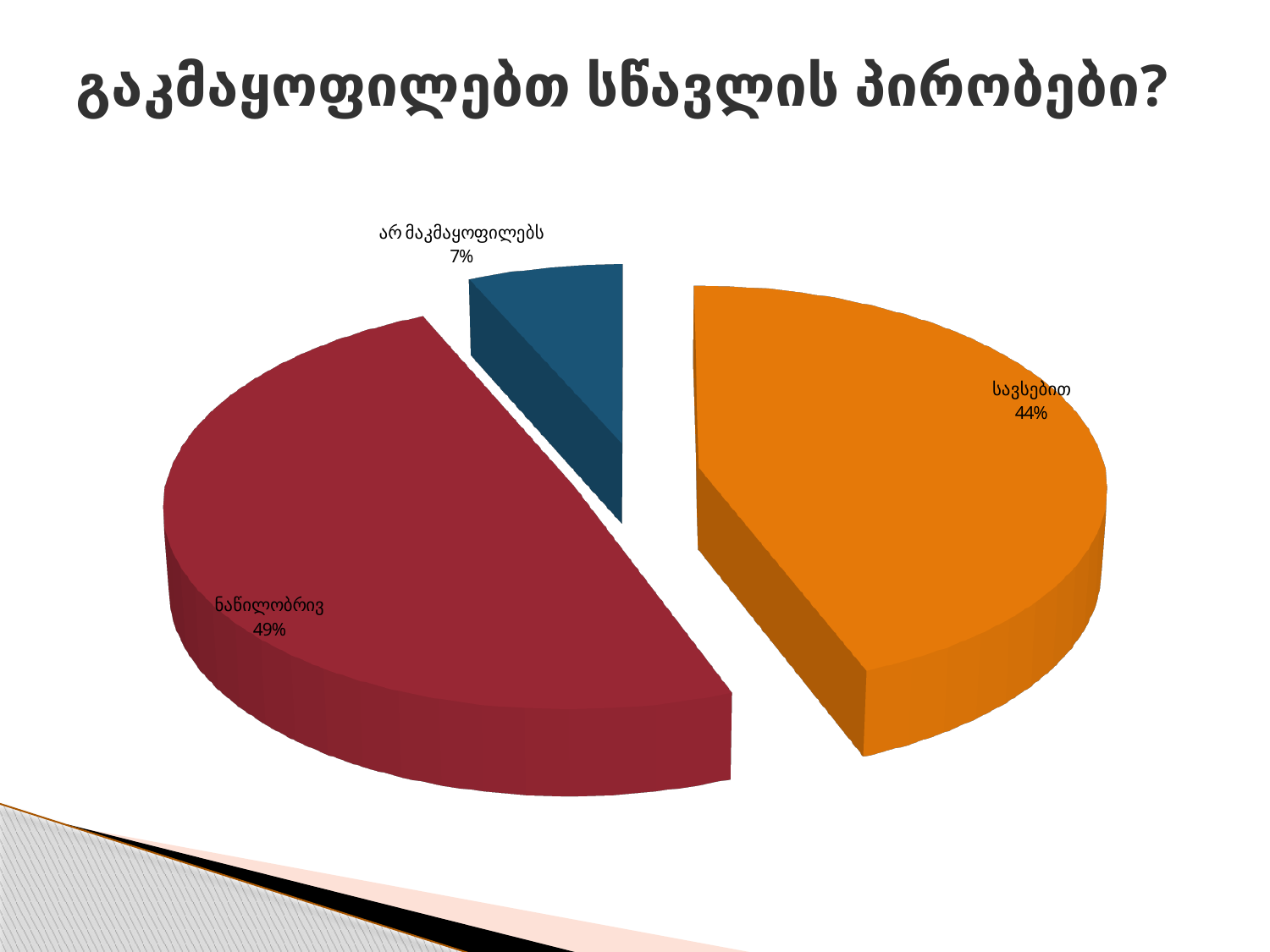
How many slices does the pie chart have? 3 What is the difference in percentage points between "ნაწილობრივ" and "სავსებით"? 5 Which category has the largest share of the pie? ნაწილობრივ What percentage of the pie is labelled "ნაწილობრივ"? 49% What kind of chart is shown on the slide? Pie chart What is the difference in percentage points between "სავსებით" and "არ მაკმაყოფილებს"? 37 What colour is the slice labelled "სავსებით"? Orange What percentage of the pie is labelled "არ მაკმაყოფილებს"? 7% Which is larger, the share for "სავსებით" or the share for "არ მაკმაყოფილებს"? სავსებით What is the title of the slide containing the chart? გაკმაყოფილებთ სწავლის პირობები? Which category has the smallest share of the pie? არ მაკმაყოფილებს What percentage of the pie is labelled "სავსებით"? 44%